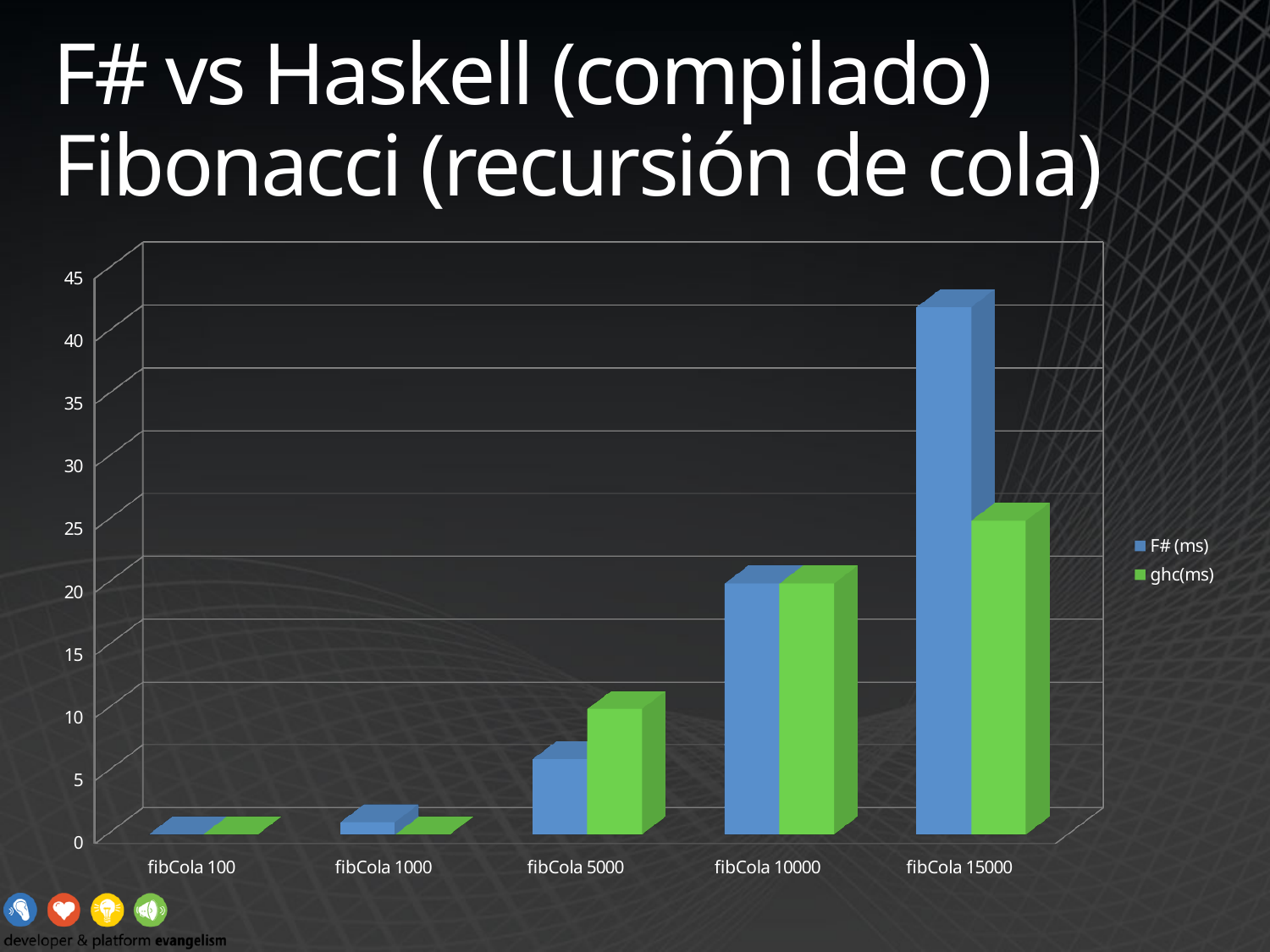
Which category has the highest value for the F# (ms) series? fibCola 15000 What kind of chart is shown on the slide? bar chart Is the ghc(ms) value for fibCola 15000 greater or less than 30? less Is the F# (ms) value for fibCola 15000 greater or less than 40? greater Is the F# (ms) value for fibCola 5000 greater or less than 10? less Which colour represents the ghc(ms) series in the legend? green For fibCola 5000, which series has the larger value, F# (ms) or ghc(ms)? ghc(ms) Which category has the highest value for the ghc(ms) series? fibCola 15000 Do the F# (ms) values rise or fall as you move from fibCola 100 to fibCola 15000? rise For fibCola 15000, which series has the larger value, F# (ms) or ghc(ms)? F# (ms) How many categories are shown on the x axis? 5 How many series does the legend list? 2